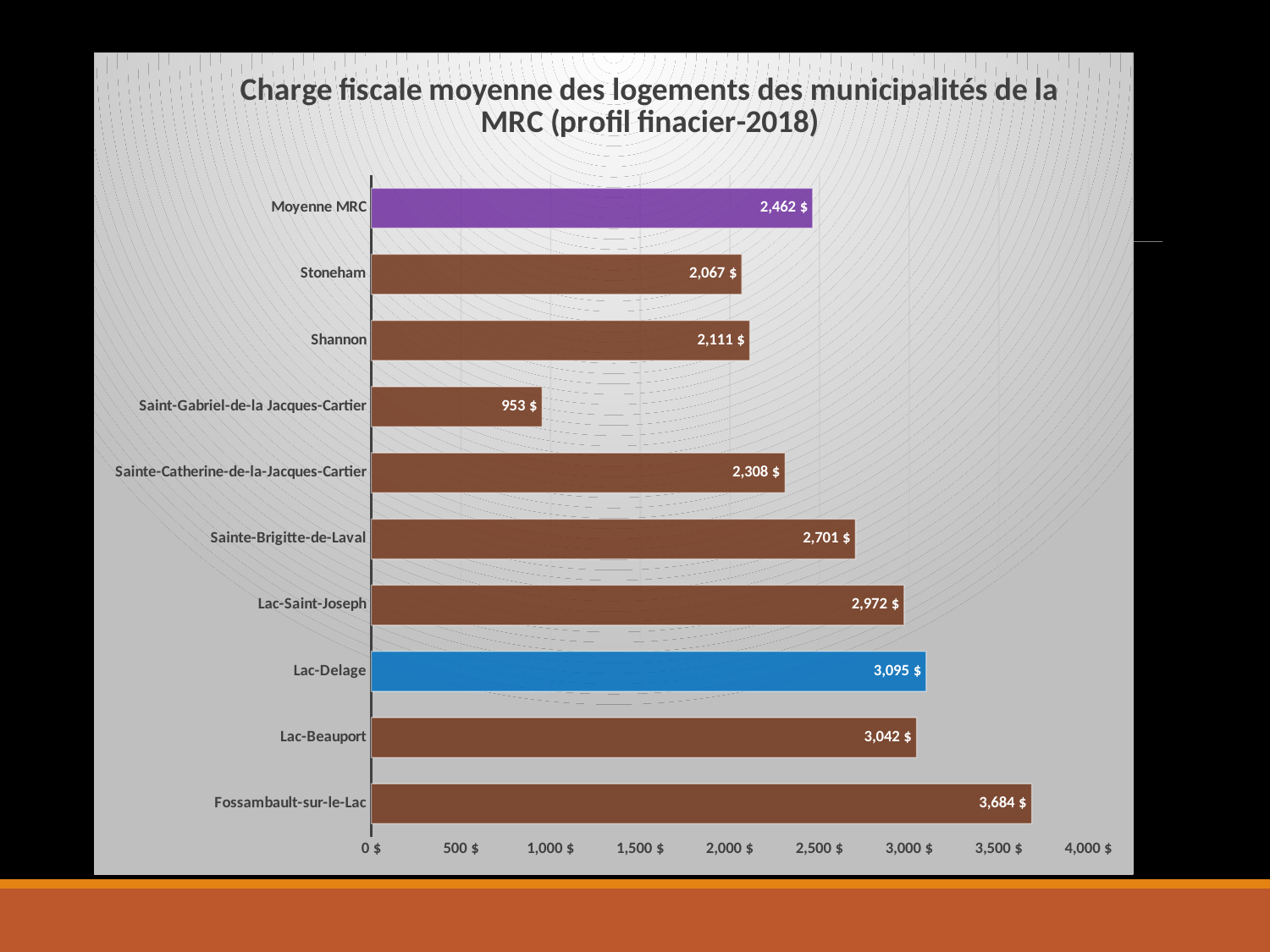
What is the title of the chart? Charge fiscale moyenne des logements des municipalités de la MRC (profil finacier-2018) What is the difference between the values for Fossambault-sur-le-Lac and Lac-Beauport? 642 $ Which bar is coloured blue? Lac-Delage Is the value for Sainte-Brigitte-de-Laval greater or less than 2,500 $? greater What is the value for Saint-Gabriel-de-la Jacques-Cartier? 953 $ Which category has the lowest value? Saint-Gabriel-de-la Jacques-Cartier What is the value for Lac-Delage? 3,095 $ What is the value for Moyenne MRC? 2,462 $ Which is larger, the value for Stoneham or the value for Shannon? Shannon How many bars are shown in the chart? 10 Which category has the highest value? Fossambault-sur-le-Lac What kind of chart is shown on the slide? Bar chart